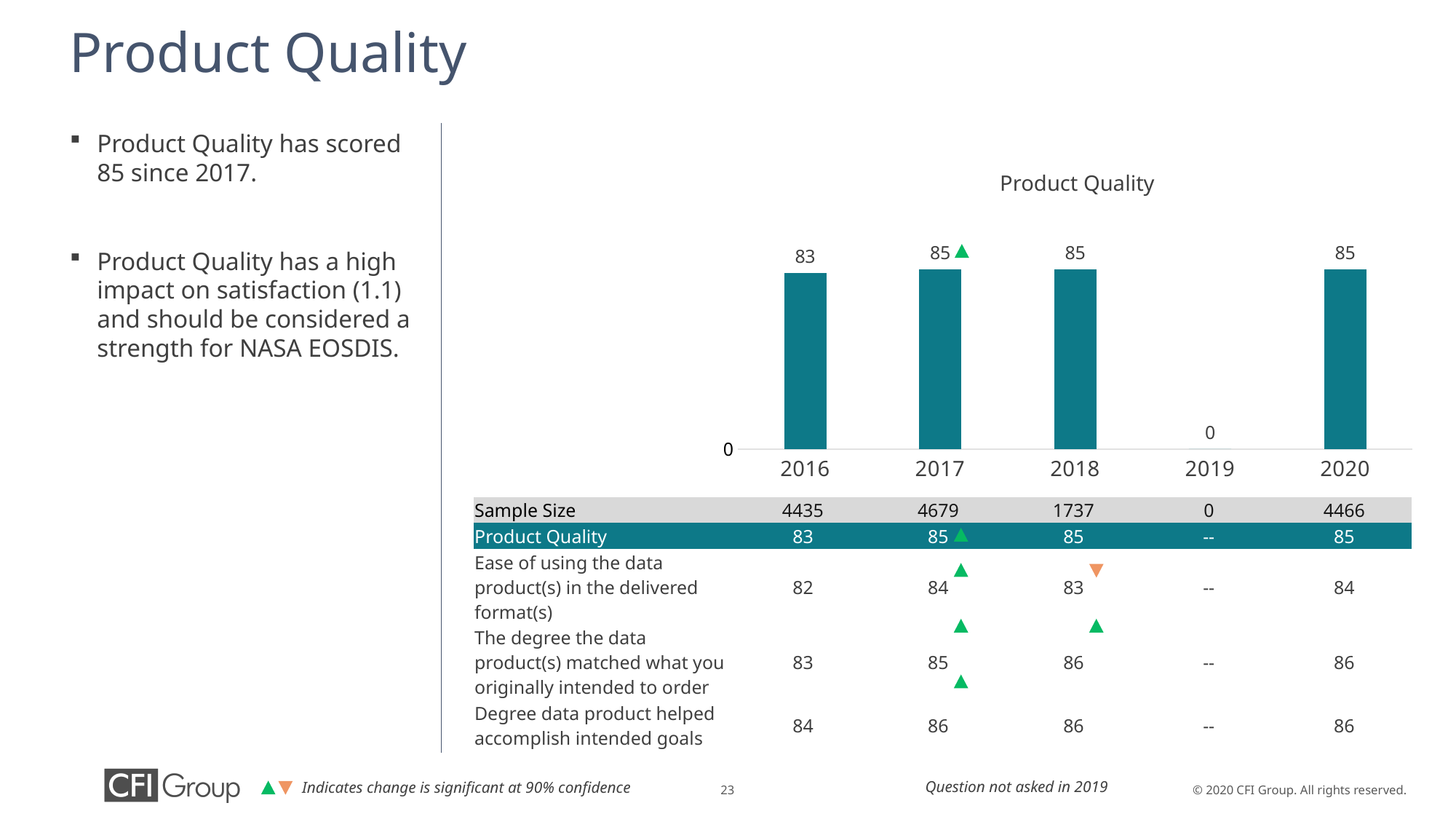
What kind of chart is used to show Product Quality? bar chart What is the Product Quality score for 2016 in the chart? 83 Which year has the lowest non-zero Product Quality score in the chart? 2016 What is the title of the chart? Product Quality What value is shown for 2019 in the Product Quality chart? 0 Did the Product Quality score rise or fall from 2016 to 2017? rise What is the difference between the Product Quality scores for 2017 and 2016? 2 Which year in the chart has a green triangle next to its data label? 2017 What is the Product Quality score for 2020 in the chart? 85 How many years are shown on the x axis of the Product Quality chart? 5 Is the Product Quality score for 2017 larger or smaller than the score for 2016? larger Is the Product Quality score for 2018 the same as the score for 2020? yes